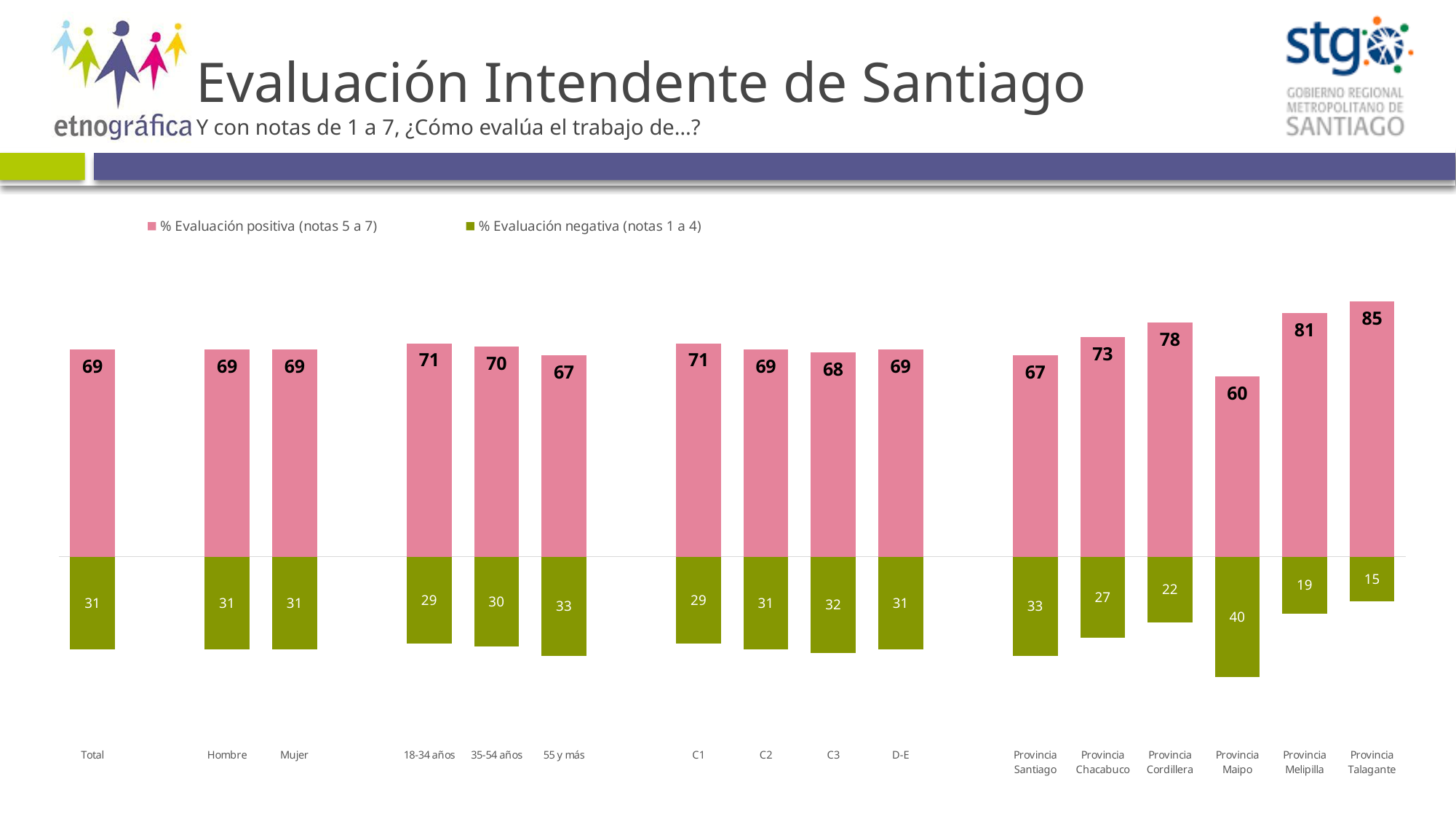
Which category has the highest % Evaluación positiva value? Provincia Talagante How many series does the legend list? 2 What is the % Evaluación positiva value for 55 y más? 67 How many categories are shown on the x axis? 16 What is the % Evaluación positiva value for Provincia Talagante? 85 What is the difference between the % Evaluación positiva values for Provincia Melipilla and Provincia Maipo? 21 Which has a larger % Evaluación positiva value, Provincia Cordillera or Provincia Chacabuco? Provincia Cordillera Which category has the lowest % Evaluación negativa value? Provincia Talagante Which category has the lowest % Evaluación positiva value? Provincia Maipo What is the total of the stacked bar for C3? 100 What kind of chart is shown on the slide? Stacked bar chart What is the % Evaluación negativa value for Provincia Maipo? 40